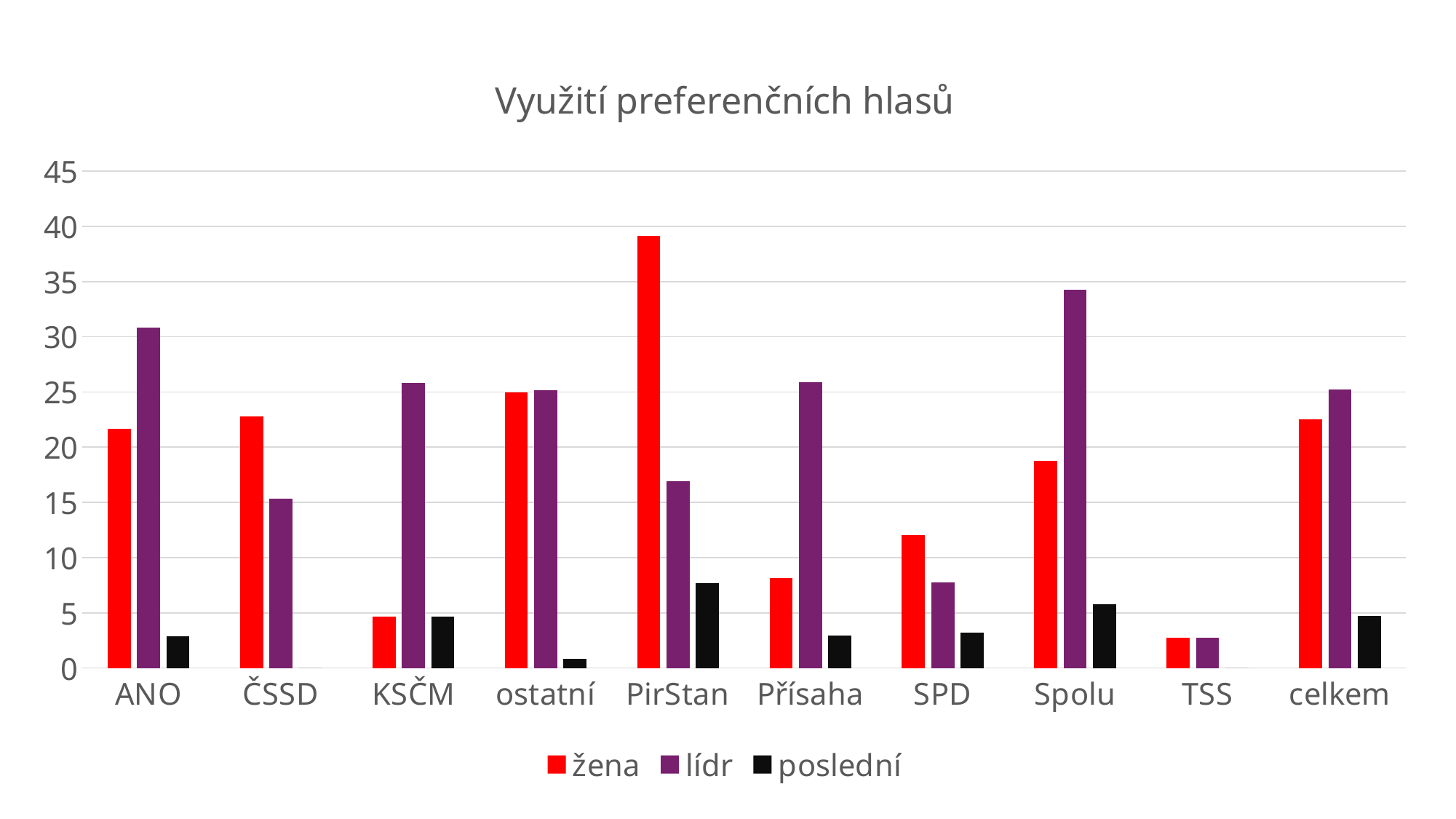
How many series does the legend list? 3 Which category has the lowest value for the lídr series? TSS What kind of chart is shown on the slide? bar chart Which category has the highest value for the poslední series? PirStan For ANO, which is larger: the žena value or the lídr value? lídr What is the title of the chart? Využití preferenčních hlasů Is the lídr value for ČSSD greater or less than 20? less Is the žena value for PirStan greater or less than 35? greater Which category has the highest value for the lídr series? Spolu How many categories are shown on the x axis? 10 Which category has the highest value for the žena series? PirStan For SPD, which is larger: the žena value or the lídr value? žena